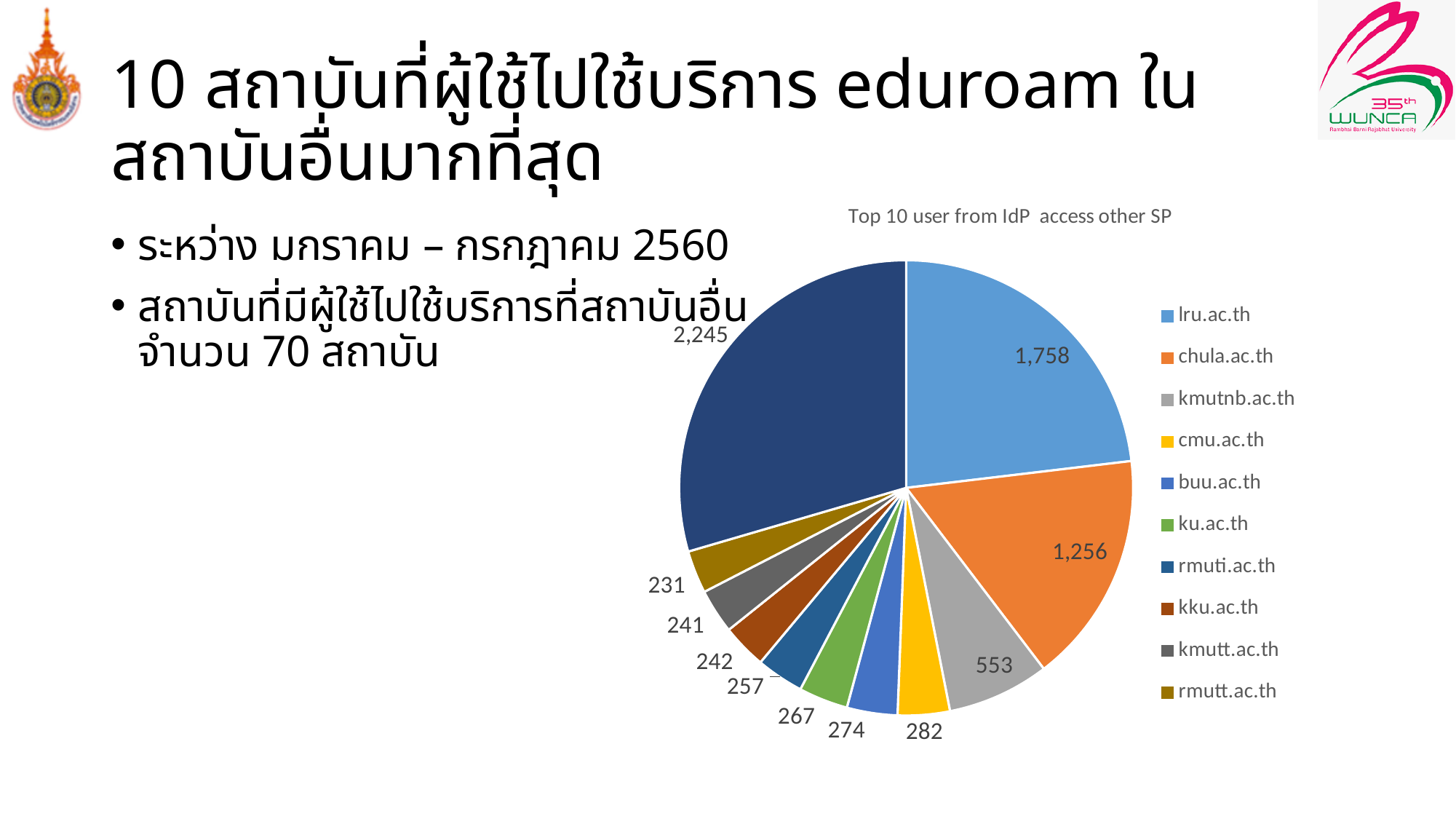
What is the value for chula.ac.th? 1,256 What is the value for rmutt.ac.th? 231 What is the value for kku.ac.th? 242 What is the value for lru.ac.th? 1,758 What is the value for cmu.ac.th? 282 What kind of chart is shown on the slide? pie chart How many entries does the legend list? 10 What is the value for kmutnb.ac.th? 553 Which has a larger value, buu.ac.th or ku.ac.th? buu.ac.th Which of the institutions listed in the legend has the smallest value? rmutt.ac.th What is the difference between the values for lru.ac.th and chula.ac.th? 502 What is the title of the chart? Top 10 user from IdP access other SP